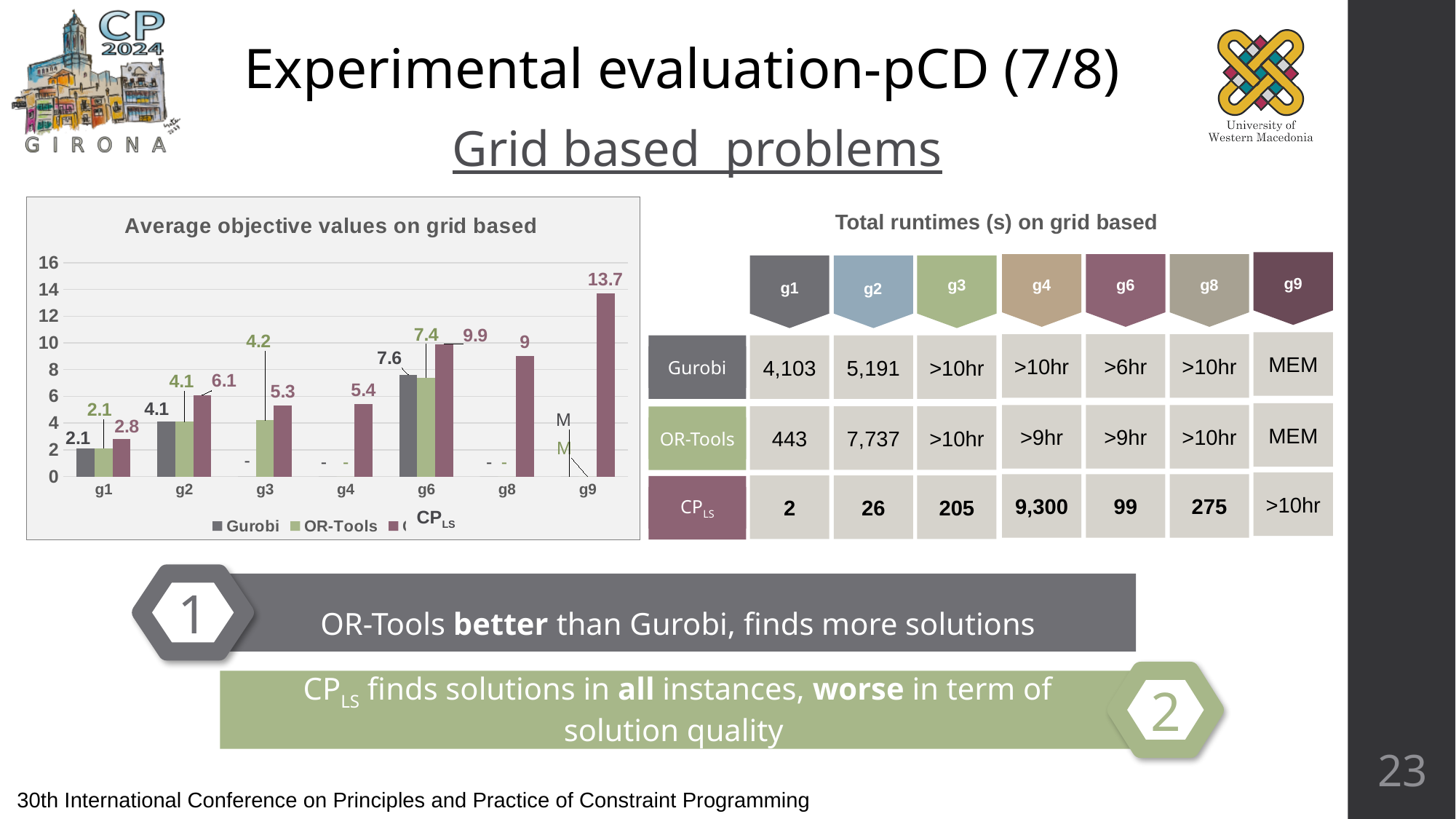
What is the difference between the CP_LS and Gurobi values for g6? 2.3 How many series does the chart's legend list? 3 Which category has the highest CP_LS average objective value? g9 For g2, which is larger: the CP_LS value or the OR-Tools value? CP_LS How many categories are shown on the x axis of the chart? 7 What is the OR-Tools average objective value for g3? 4.2 What kind of chart is used to show the average objective values on grid based problems? Bar chart What is the CP_LS average objective value for g2? 6.1 What is the CP_LS average objective value for g9 in the chart? 13.7 Which category has the lowest CP_LS average objective value? g1 What is the Gurobi average objective value for g6? 7.6 What is the title of the chart on the slide? Average objective values on grid based